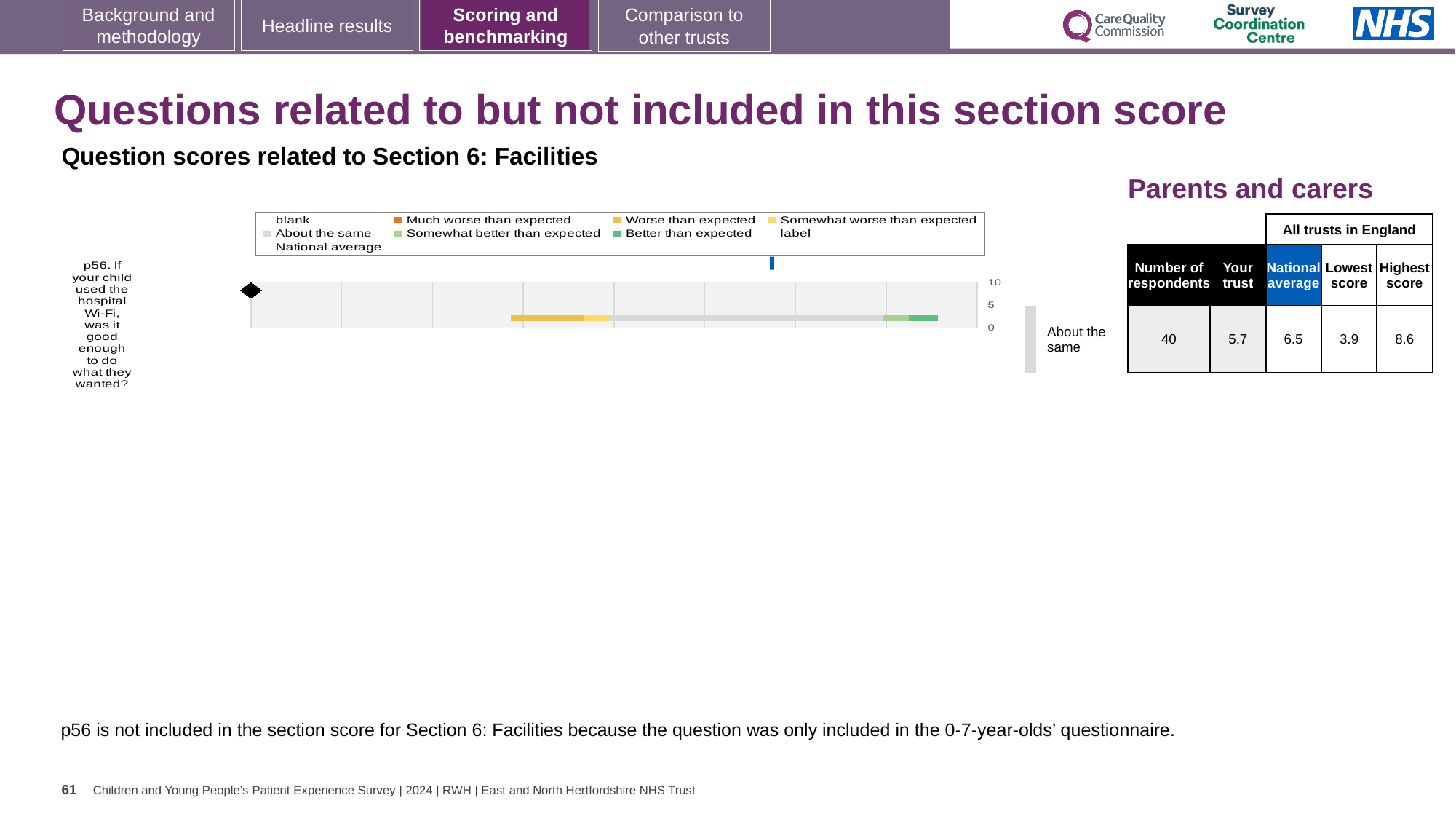
Which respondent group does the chart on this slide cover? Parents and carers What is the national average score for question p56? 6.5 What is the highest score among all trusts in England for question p56? 8.6 How many questions are plotted in the chart? 1 What is the difference between the highest and lowest trust scores for question p56? 4.7 Which benchmark category is the trust's result for p56 placed in? About the same What is the difference between the national average and the trust's score for question p56? 0.8 Is the trust's score for question p56 greater or less than 5? greater What is the lowest score among all trusts in England for question p56? 3.9 How many respondents answered question p56? 40 Which is larger for question p56: the trust's score or the national average? National average What is the 'Your trust' score for question p56 about hospital Wi-Fi? 5.7